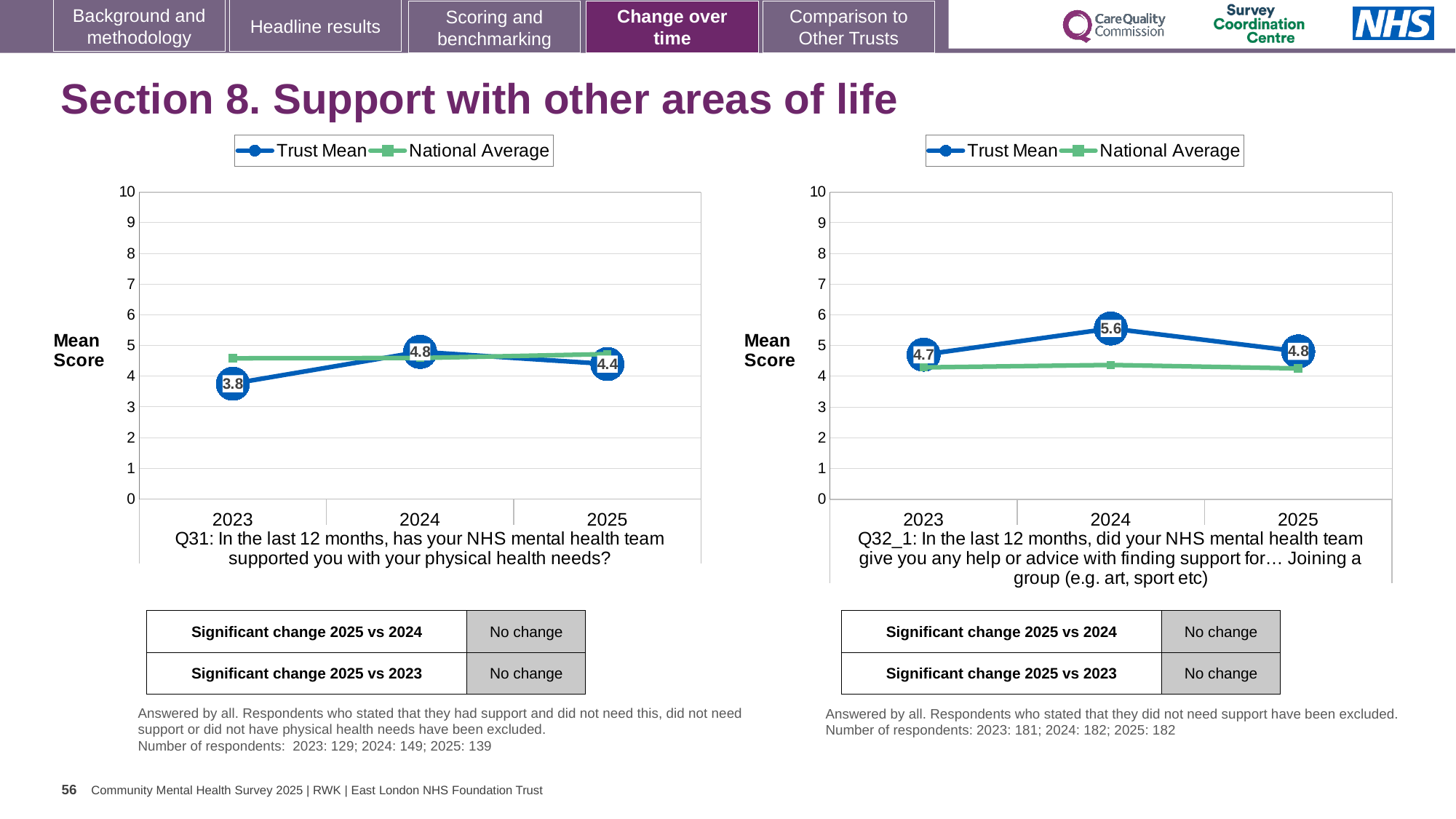
What type of chart is the right chart (Q32_1)? Line chart On the right chart (Q32_1), in which year is the Trust Mean lowest? 2023 On the left chart (Q31), is the Trust Mean for 2023 greater or less than 4? less On the left chart (Q31), what is the Trust Mean score for 2023? 3.8 On the right chart (Q32_1), is the National Average for 2024 greater or less than 5? less On the right chart (Q32_1), what is the difference between the Trust Mean in 2024 and in 2025? 0.8 On the right chart (Q32_1), what is the Trust Mean score for 2024? 5.6 On the left chart (Q31), what is the Trust Mean score for 2025? 4.4 On the left chart (Q31), in which year is the Trust Mean highest? 2024 On the right chart (Q32_1), which is larger in 2024, the Trust Mean or the National Average? Trust Mean On the left chart (Q31), what is the difference between the Trust Mean in 2024 and in 2023? 1.0 How many series does the legend of the left chart list? 2